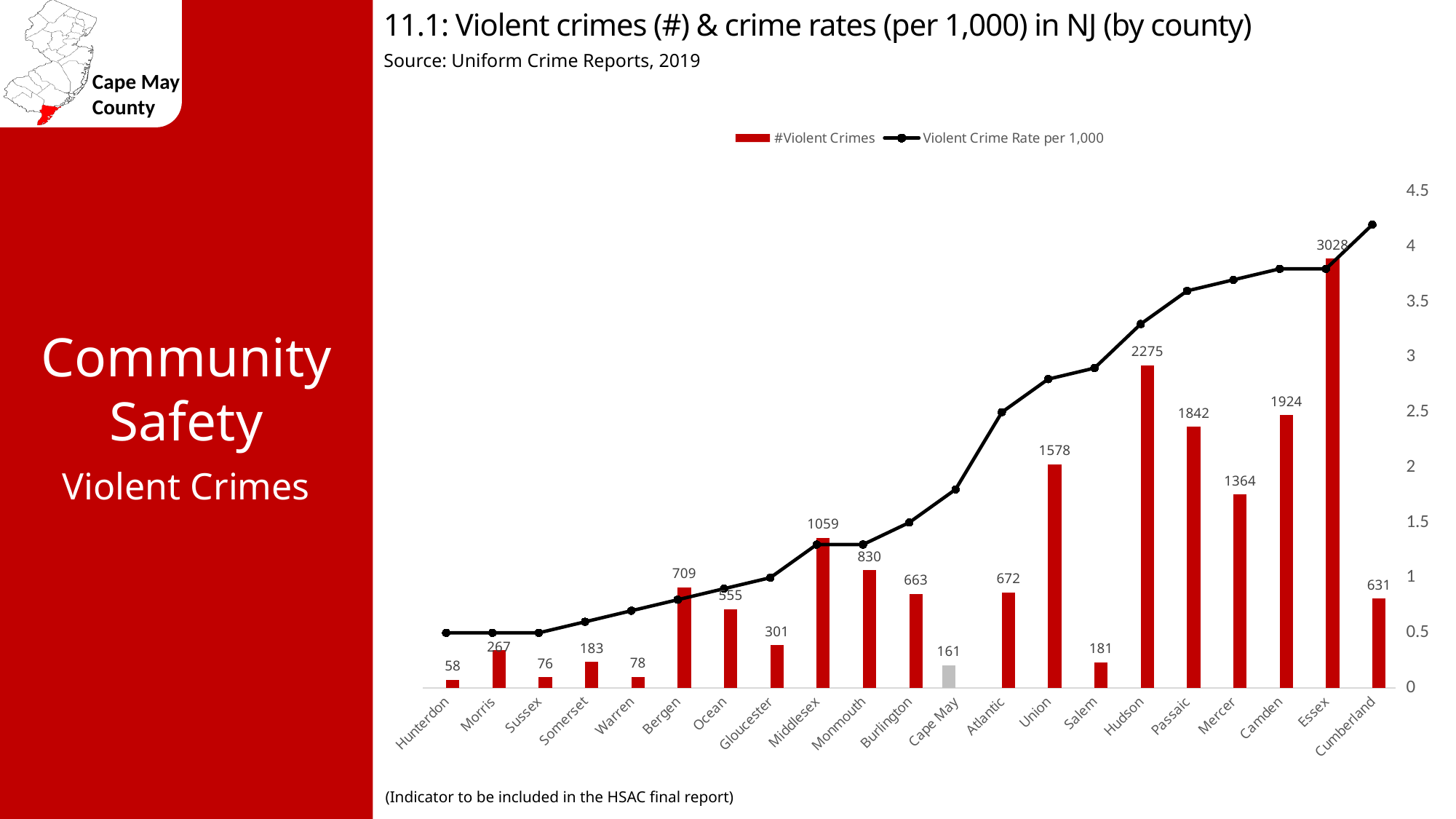
What is the number of violent crimes for Cape May? 161 Which county has more violent crimes, Camden or Passaic? Camden Is the violent crime rate per 1,000 for Cape May greater or less than 1.5? greater What kind of chart is this? A combined bar and line chart Is the violent crime rate per 1,000 for Cumberland greater or less than 4? greater Which county has the highest number of violent crimes? Essex What is the difference in the number of violent crimes between Hudson and Passaic? 433 What is the number of violent crimes for Essex? 3028 How many series does the legend list? 2 Which county has the lowest number of violent crimes? Hunterdon How many counties are shown on the x axis of the chart? 21 Does the violent crime rate per 1,000 line generally rise or fall from Hunterdon to Cumberland? rise